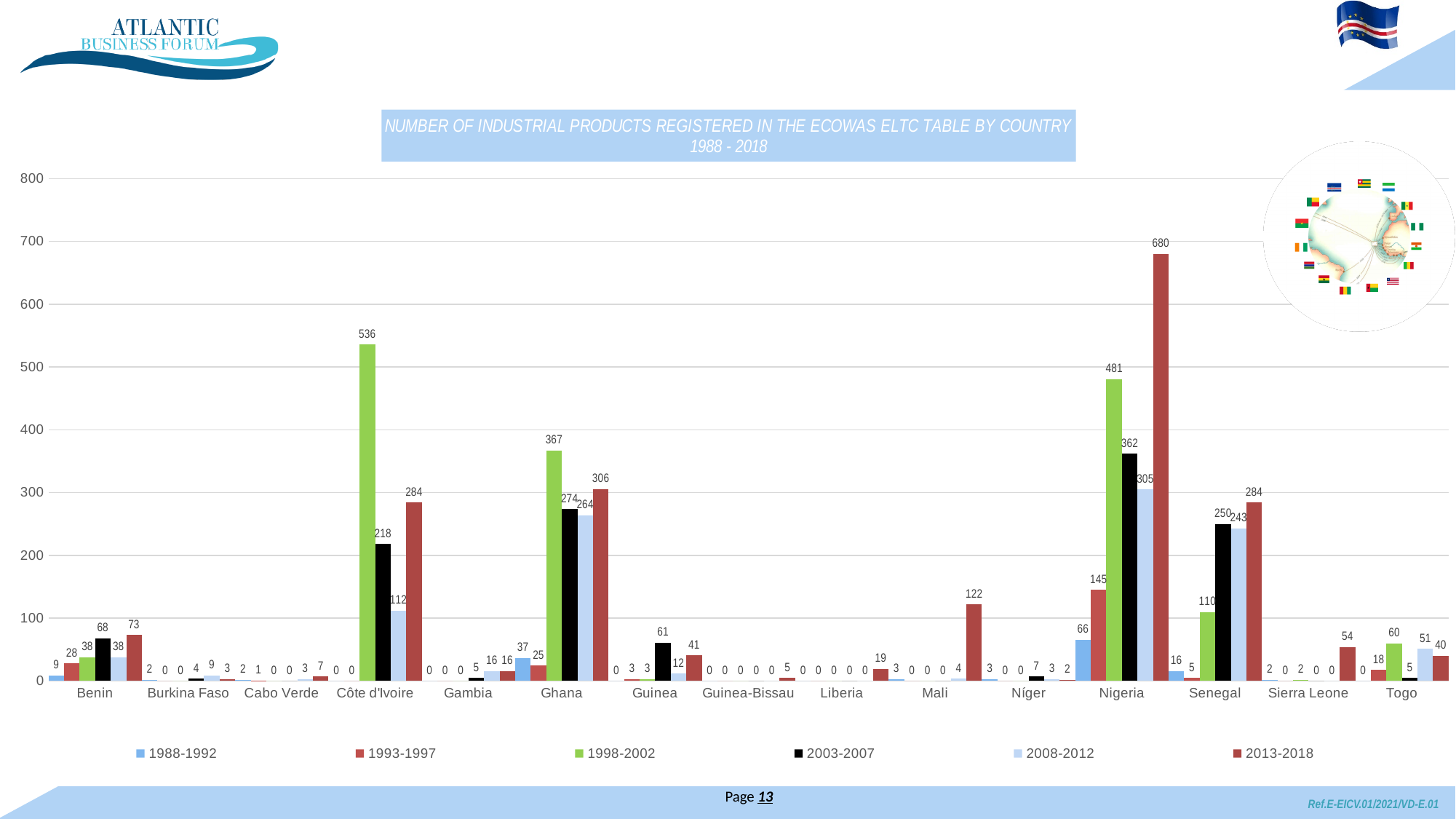
What is the value for Mali in the 2013-2018 series? 122 Which is larger: Senegal's 2013-2018 value or Ghana's 2013-2018 value? Ghana's 2013-2018 value What is the value for Ghana in the 2003-2007 series? 274 What type of chart is shown on the slide? bar chart What is the difference between Nigeria's 2013-2018 value and its 2008-2012 value? 375 What is the value for Nigeria in the 2013-2018 series? 680 How many series does the legend list? 6 What is the value for Côte d'Ivoire in the 1998-2002 series? 536 Which country has the highest value in the 1998-2002 series? Côte d'Ivoire What is the title of the chart? NUMBER OF INDUSTRIAL PRODUCTS REGISTERED IN THE ECOWAS ELTC TABLE BY COUNTRY 1988 - 2018 Which country has the highest value in the 2013-2018 series? Nigeria How many countries are shown on the x axis? 15